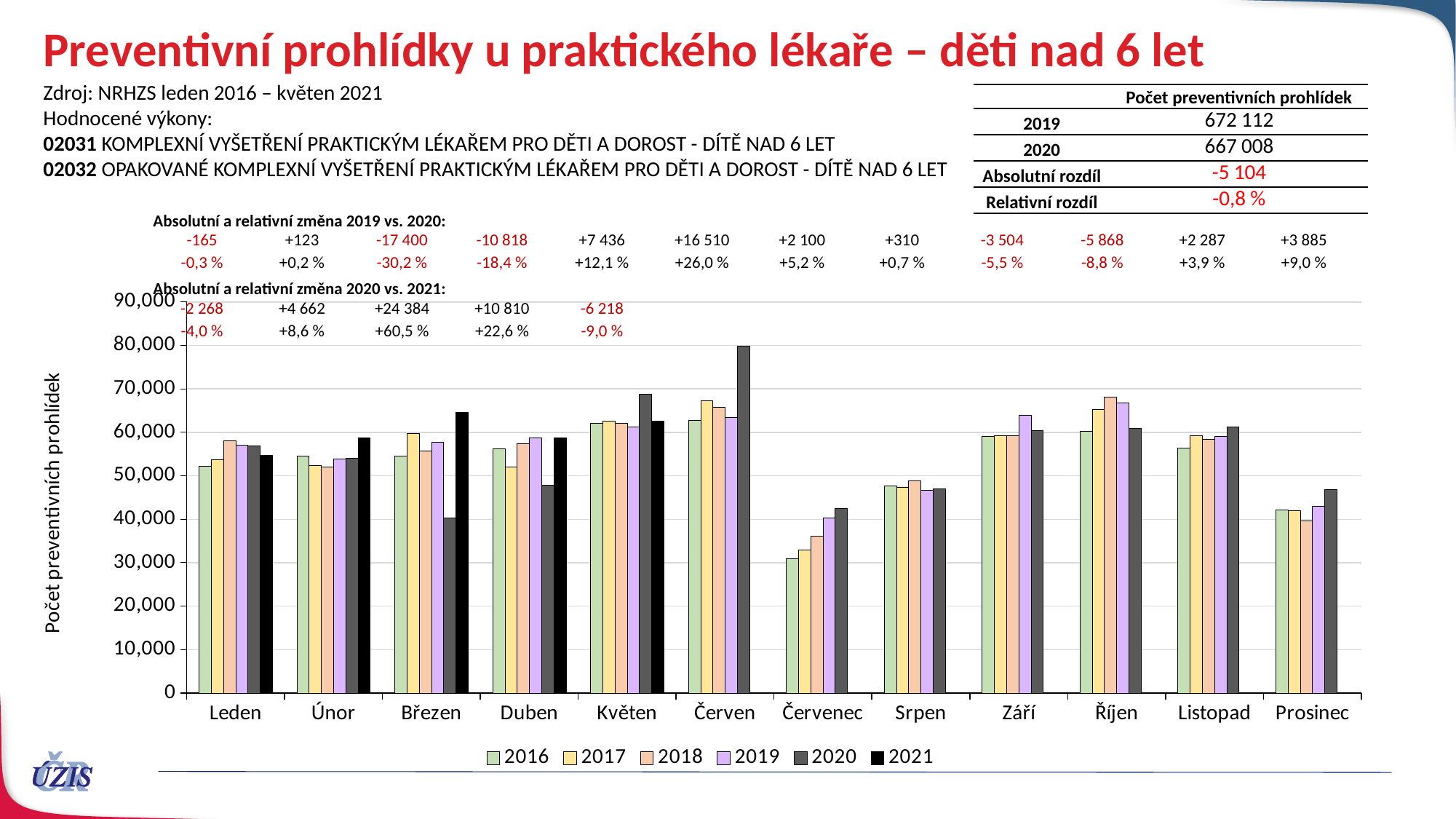
What colour does the legend use for the 2021 series? black In Březen, which is larger: the 2020 bar or the 2021 bar? 2021 Is the 2020 value for Červen greater or less than 70,000? greater Which month has the lowest 2016 value in the chart? Červenec Is the 2021 value for Duben greater or less than 50,000? greater What kind of chart is shown on the slide? bar chart Which month has the highest 2020 value in the chart? Červen Is the 2019 value for Březen greater or less than 50,000? greater What is the relative change 2020 vs. 2021 printed above the chart for Březen? +60,5 % How many months (categories) are shown on the x axis of the chart? 12 What is the absolute change 2019 vs. 2020 printed above the chart for Březen? -17 400 How many series does the chart legend list? 6